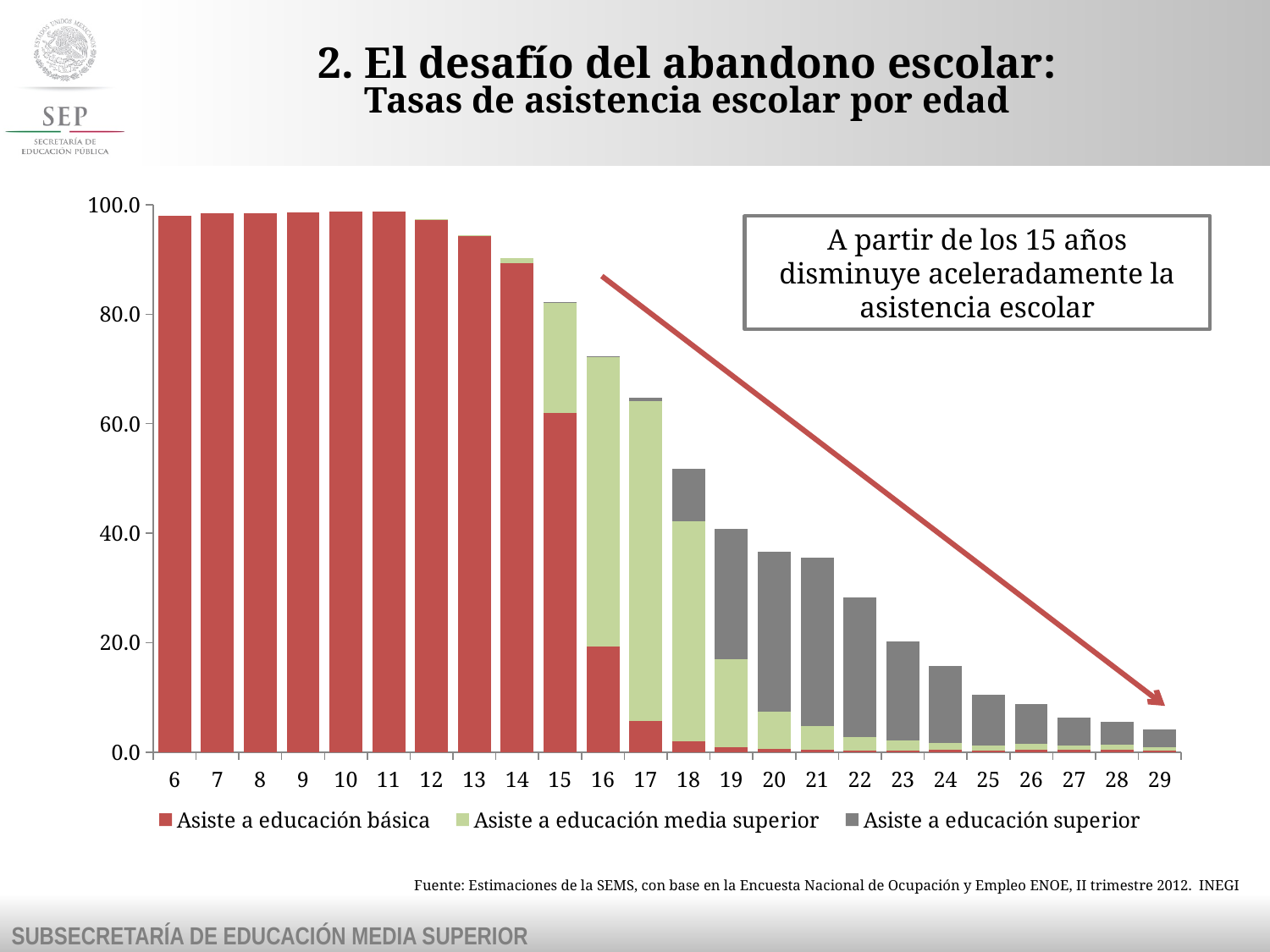
Which age has the lowest total school attendance rate in the chart? 29 How many series does the chart's legend list? 3 Is the total attendance rate for age 14 greater or less than 80? greater Do the total attendance rates rise or fall from age 15 to age 29? fall Is the total attendance rate for age 20 greater or less than 40? less How many age categories are shown on the x axis of the chart? 24 Is the total attendance rate for age 16 greater or less than 60? greater Which series is shown in red in the chart? Asiste a educación básica What is the subtitle of the chart on the slide? Tasas de asistencia escolar por edad What kind of chart is shown on the slide? stacked bar chart Which has a higher total attendance rate, age 13 or age 19? 13